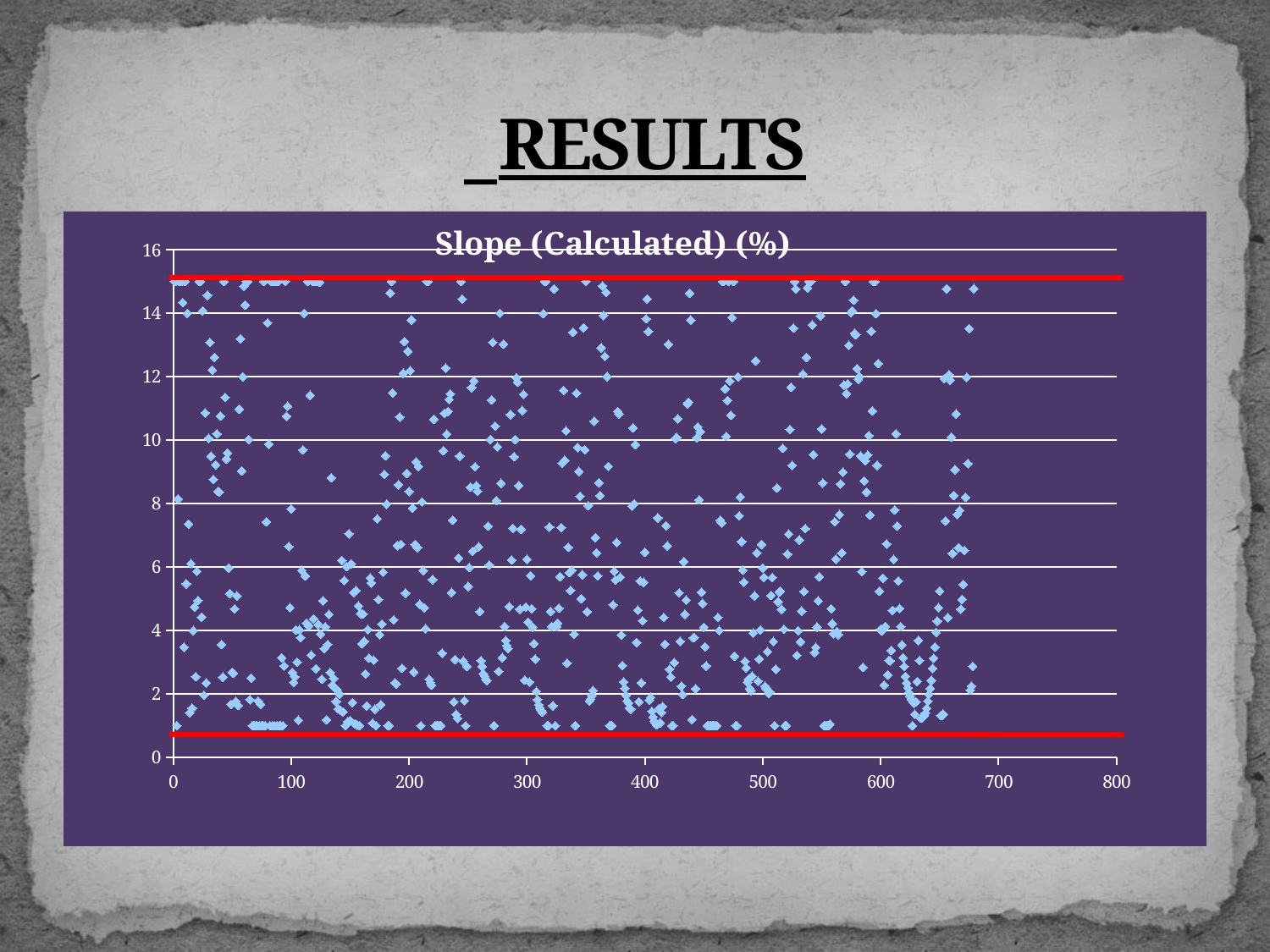
What kind of chart is shown on the slide? scatter chart How many horizontal red lines are drawn across the chart? 2 How many data points are plotted beyond 700 on the x axis? 0 What is the title of the chart? Slope (Calculated) (%) Is the lower red line on the chart greater or less than 2 on the y axis? less Is the upper red line on the chart greater or less than 16 on the y axis? less Do all the plotted points lie between the two red lines? Yes Is the upper red line on the chart greater or less than 14 on the y axis? greater